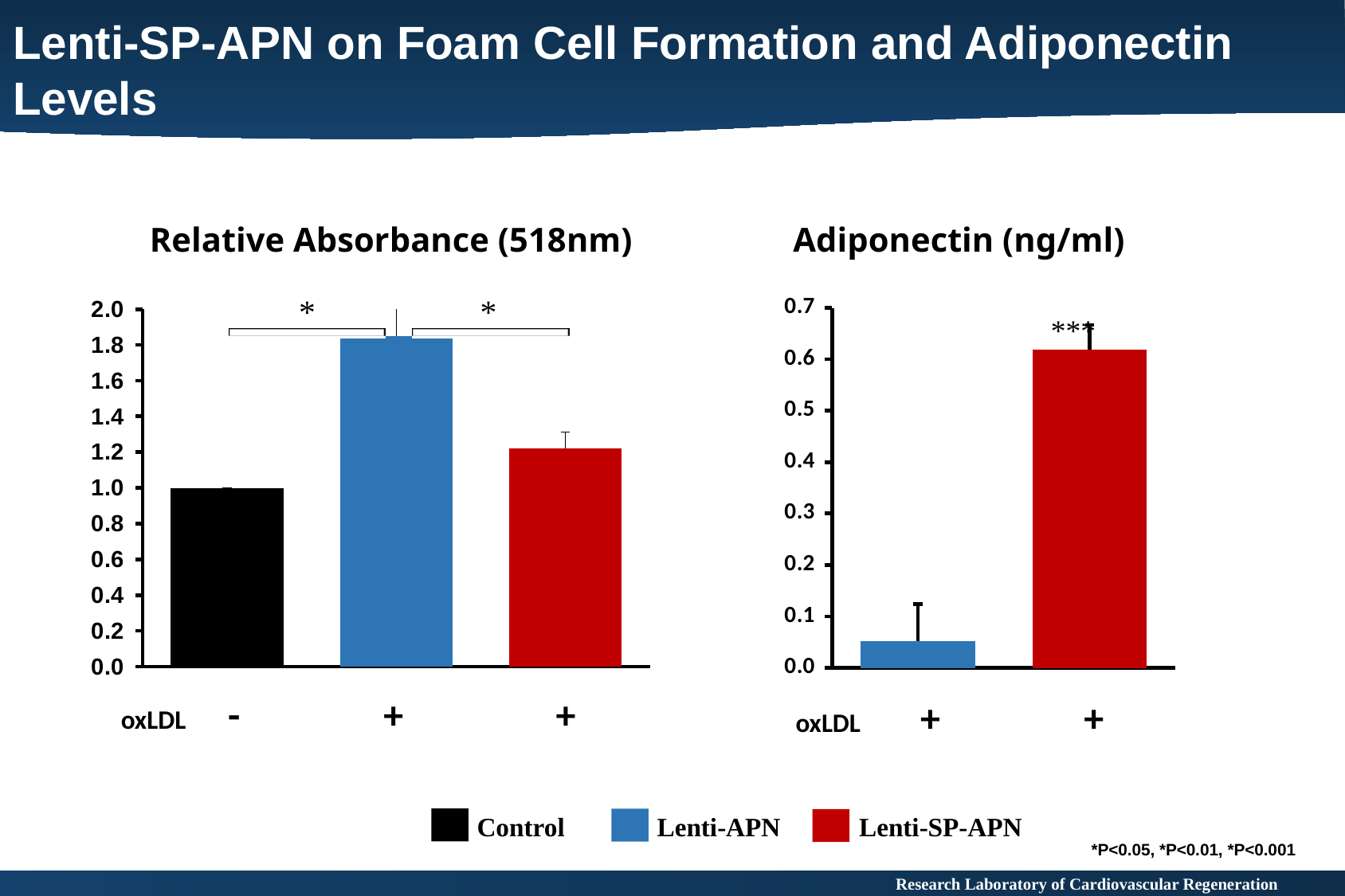
In the Adiponectin (ng/ml) chart, is the value for Lenti-SP-APN greater or less than 0.5? greater What kind of chart is the Relative Absorbance (518nm) chart? bar chart In the Relative Absorbance (518nm) chart, what is the value for Control? 1.0 In the Relative Absorbance (518nm) chart, which group has the highest bar? Lenti-APN In the Relative Absorbance (518nm) chart, which group has the lowest bar? Control In the Relative Absorbance (518nm) chart, is the value for Lenti-APN greater or less than 1.6? greater In the Relative Absorbance (518nm) chart, how many bars are plotted? 3 In the Adiponectin (ng/ml) chart, is the value for Lenti-APN greater or less than 0.1? less In the Adiponectin (ng/ml) chart, which group has the higher bar? Lenti-SP-APN What colour represents Lenti-SP-APN in the legend? red How many groups does the shared legend list? 3